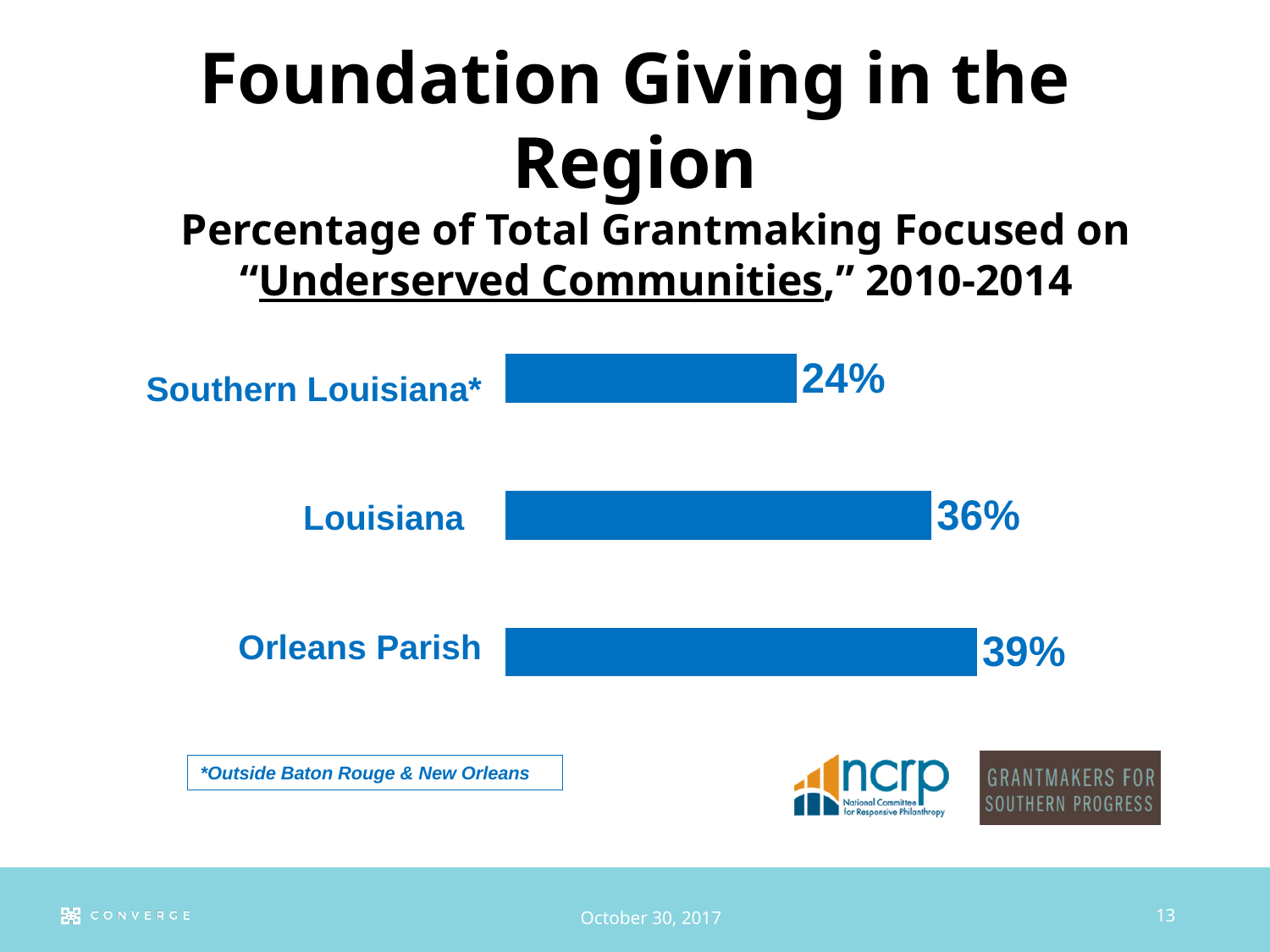
Which has a higher percentage, Louisiana or Southern Louisiana*? Louisiana Which region has the lowest percentage of grantmaking focused on underserved communities? Southern Louisiana* What percentage of total grantmaking was focused on underserved communities in Southern Louisiana*? 24% What is the difference in percentage points between Louisiana and Southern Louisiana*? 12 What percentage of total grantmaking was focused on underserved communities in Orleans Parish? 39% How many regions are shown in the chart? 3 According to the footnote, what does the asterisk on Southern Louisiana* mean? Outside Baton Rouge & New Orleans What kind of chart is shown on the slide? Bar chart What is the difference in percentage points between Orleans Parish and Southern Louisiana*? 15 Which region has the highest percentage of grantmaking focused on underserved communities? Orleans Parish What percentage of total grantmaking was focused on underserved communities in Louisiana? 36% What time period does the chart cover, according to its title? 2010-2014